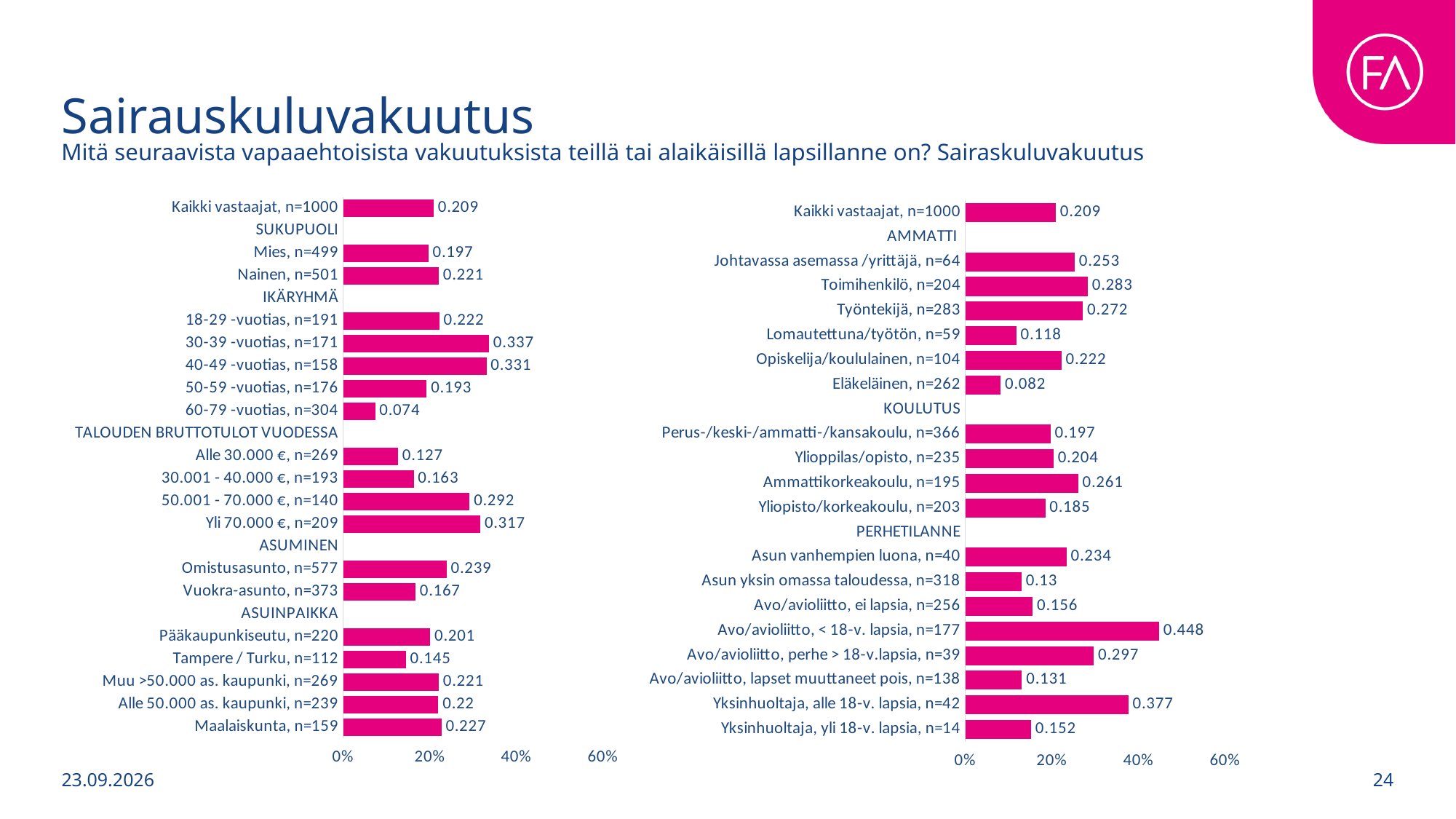
In the left chart, what is the value for Mies, n=499? 0.197 In the right chart, which category has the highest value? Avo/avioliitto, < 18-v. lapsia, n=177 In the left chart, which category has the lowest value? 60-79 -vuotias, n=304 In the right chart, what is the value for Eläkeläinen, n=262? 0.082 In the left chart, which category has the highest value? 30-39 -vuotias, n=171 In the right chart, which category has the lowest value? Eläkeläinen, n=262 In the left chart, is the value for Omistusasunto, n=577 greater or less than 20%? greater In the left chart, what is the value for Yli 70.000 €, n=209? 0.317 In the right chart, what is the value for Ammattikorkeakoulu, n=195? 0.261 In the right chart, which is larger: the value for Yksinhuoltaja, alle 18-v. lapsia, n=42 or Yksinhuoltaja, yli 18-v. lapsia, n=14? Yksinhuoltaja, alle 18-v. lapsia, n=42 In the left chart, what is the difference between the values for Nainen, n=501 and Mies, n=499? 0.024 What kind of chart is shown on the left side of the slide? bar chart